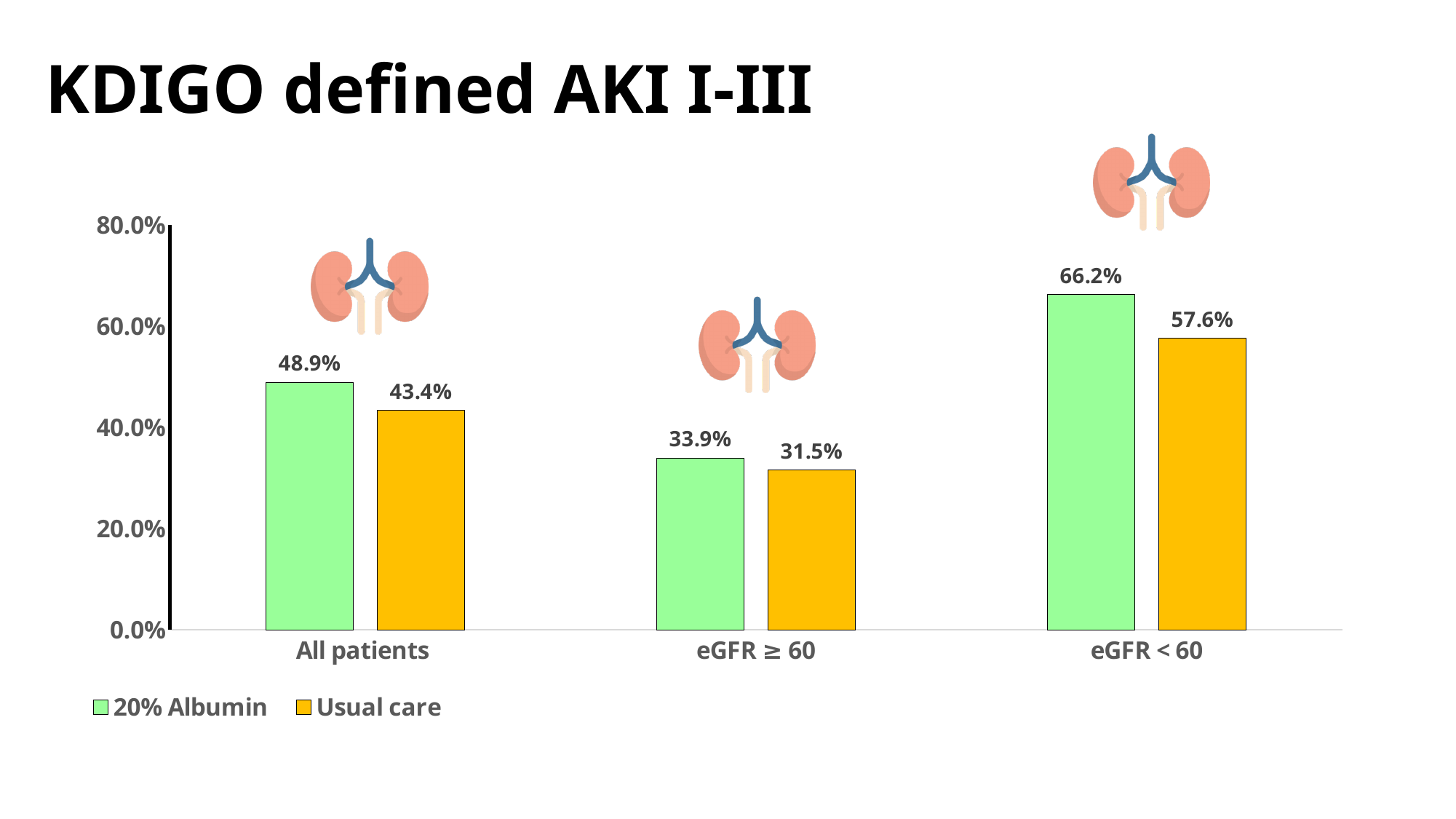
Which group has the lowest value for Usual care? eGFR ≥ 60 What is the difference between 20% Albumin and Usual care in the All patients group? 5.5% What is the value for Usual care in the eGFR ≥ 60 group? 31.5% How many series does the legend list? 2 What colour are the Usual care bars? Orange What is the value for Usual care in the eGFR < 60 group? 57.6% In the eGFR ≥ 60 group, which is larger: 20% Albumin or Usual care? 20% Albumin What is the difference between 20% Albumin and Usual care in the eGFR < 60 group? 8.6% What kind of chart is shown on the slide? Bar chart Which group has the highest value for 20% Albumin? eGFR < 60 What is the value for 20% Albumin in the All patients group? 48.9% How many patient groups are shown on the x axis? 3